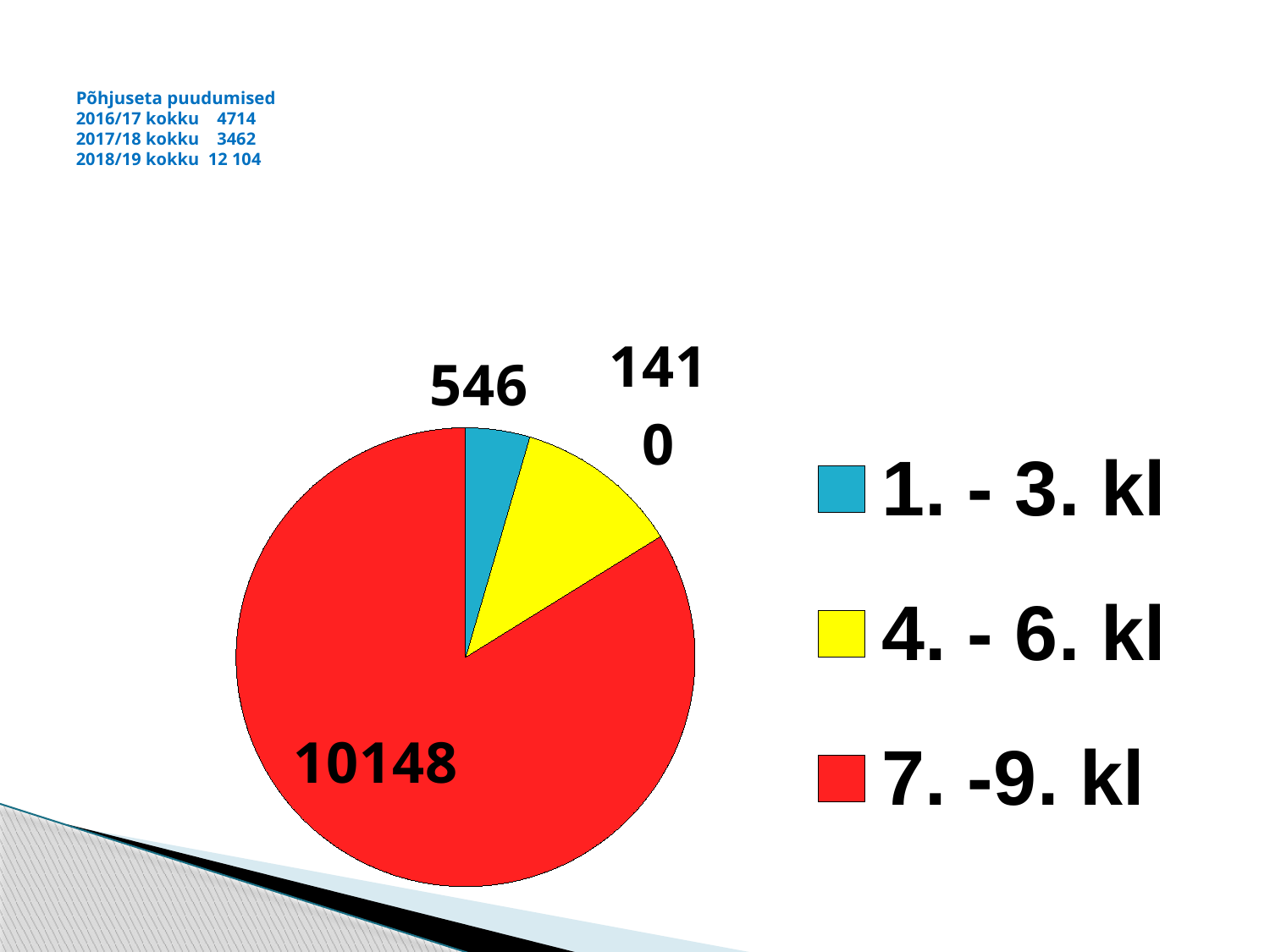
What is the value for 7. -9. kl in the pie chart? 10148 What kind of chart is shown on the slide? pie chart What is the difference between the values for 4. - 6. kl and 1. - 3. kl? 864 How many entries does the legend list? 3 What is the value for 1. - 3. kl in the pie chart? 546 What colour is the slice for 4. - 6. kl in the pie chart? yellow What is the value for 4. - 6. kl in the pie chart? 1410 How many categories does the pie chart show? 3 Which category has the smallest slice in the pie chart? 1. - 3. kl What is the difference between the values for 7. -9. kl and 1. - 3. kl? 9602 Which is larger, the value for 4. - 6. kl or the value for 1. - 3. kl? 4. - 6. kl Which category has the largest slice in the pie chart? 7. -9. kl